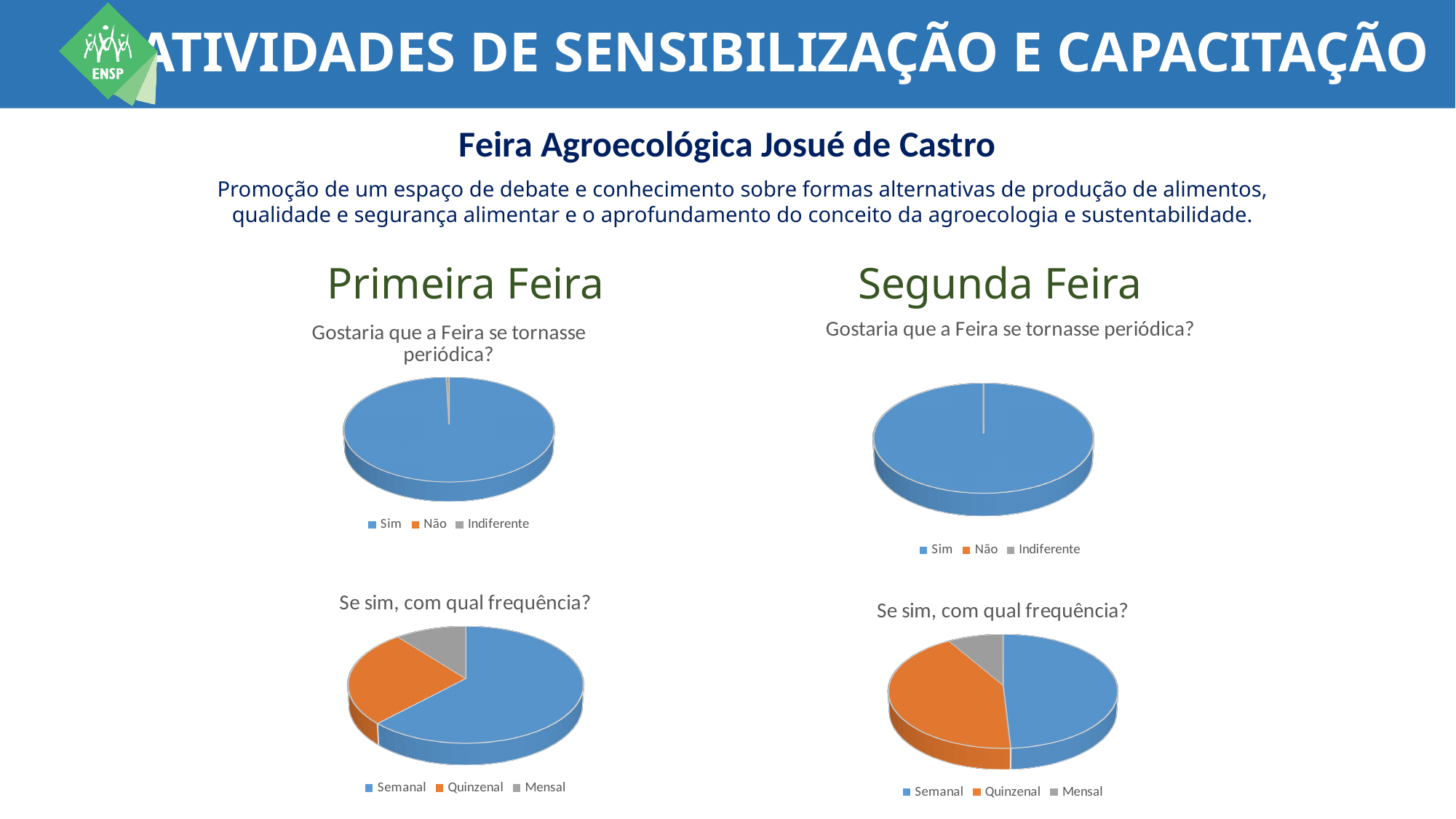
What kind of chart is used for "Se sim, com qual frequência?" under Primeira Feira? Pie chart How many charts are shown on the slide? 4 In the "Se sim, com qual frequência?" chart under Primeira Feira, which category has the largest share? Semanal How many entries does the legend list for the "Gostaria que a Feira se tornasse periódica?" chart under Primeira Feira? 3 In the "Se sim, com qual frequência?" chart under Primeira Feira, which is larger: Quinzenal or Mensal? Quinzenal In the "Gostaria que a Feira se tornasse periódica?" chart under Primeira Feira, which category has the largest share? Sim In the "Gostaria que a Feira se tornasse periódica?" chart under Segunda Feira, which category has the largest share? Sim What are the legend entries of the "Se sim, com qual frequência?" chart under Segunda Feira? Semanal, Quinzenal, Mensal In the "Se sim, com qual frequência?" chart under Primeira Feira, which category has the smallest share? Mensal What colour represents Quinzenal in the "Se sim, com qual frequência?" charts? Orange In the "Se sim, com qual frequência?" chart under Segunda Feira, which category has the smallest share? Mensal